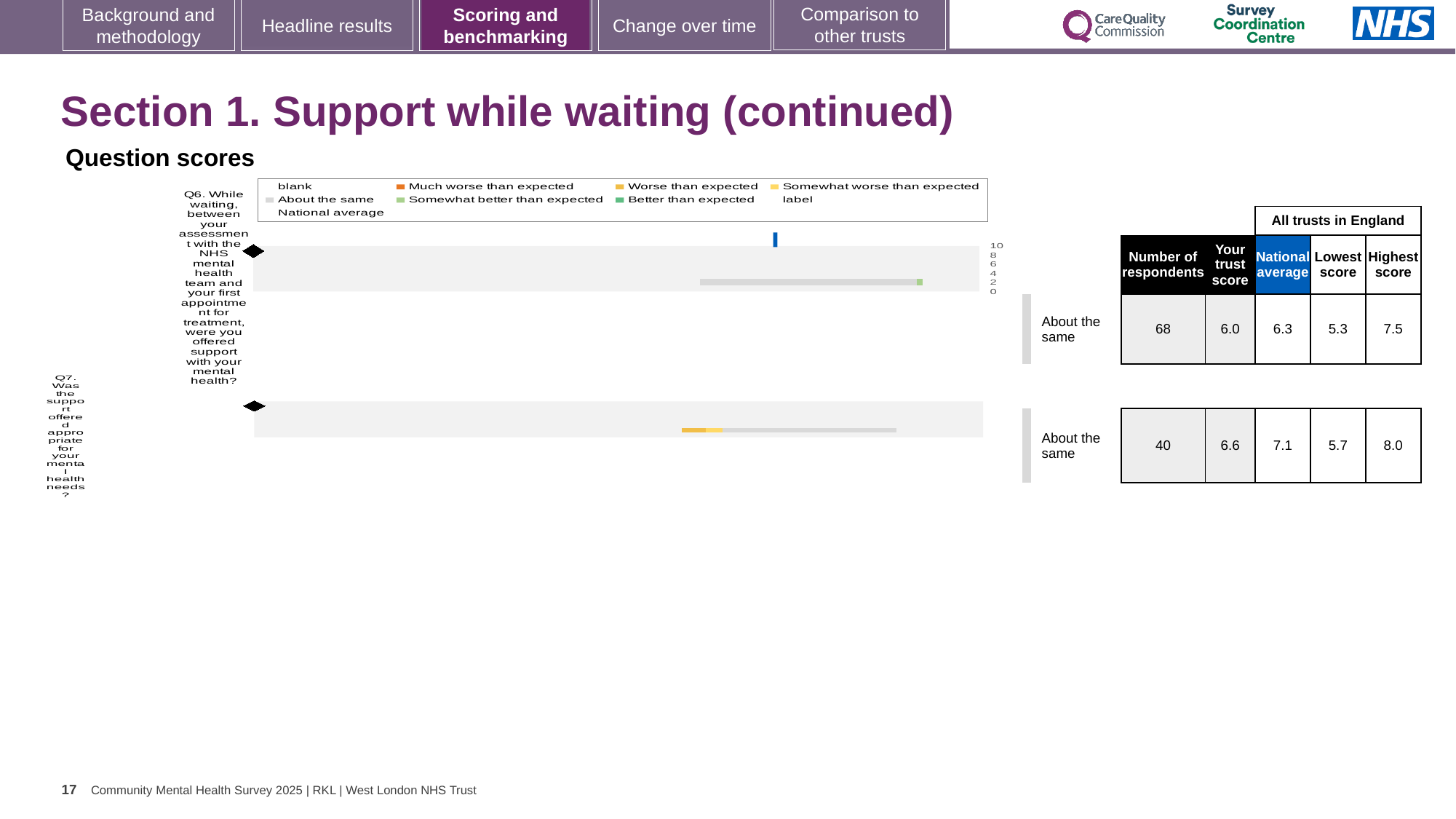
What is the difference between the national average and the trust score for Q6? 0.3 What kind of chart is shown under 'Question scores'? bar chart How many questions (categories) are plotted in the chart? 2 What is the difference between the highest and lowest scores for Q7? 2.3 What is the 'Your trust score' for Q6? 6.0 How many entries does the chart legend list? 9 What is the highest score among all trusts in England for Q7? 8.0 Which question has the higher trust score, Q6 or Q7? Q7 What benchmark category label is shown next to the Q7 bar? About the same How many respondents answered Q6? 68 What is the national average score for Q7? 7.1 For Q6, which is larger: the trust score or the national average? national average